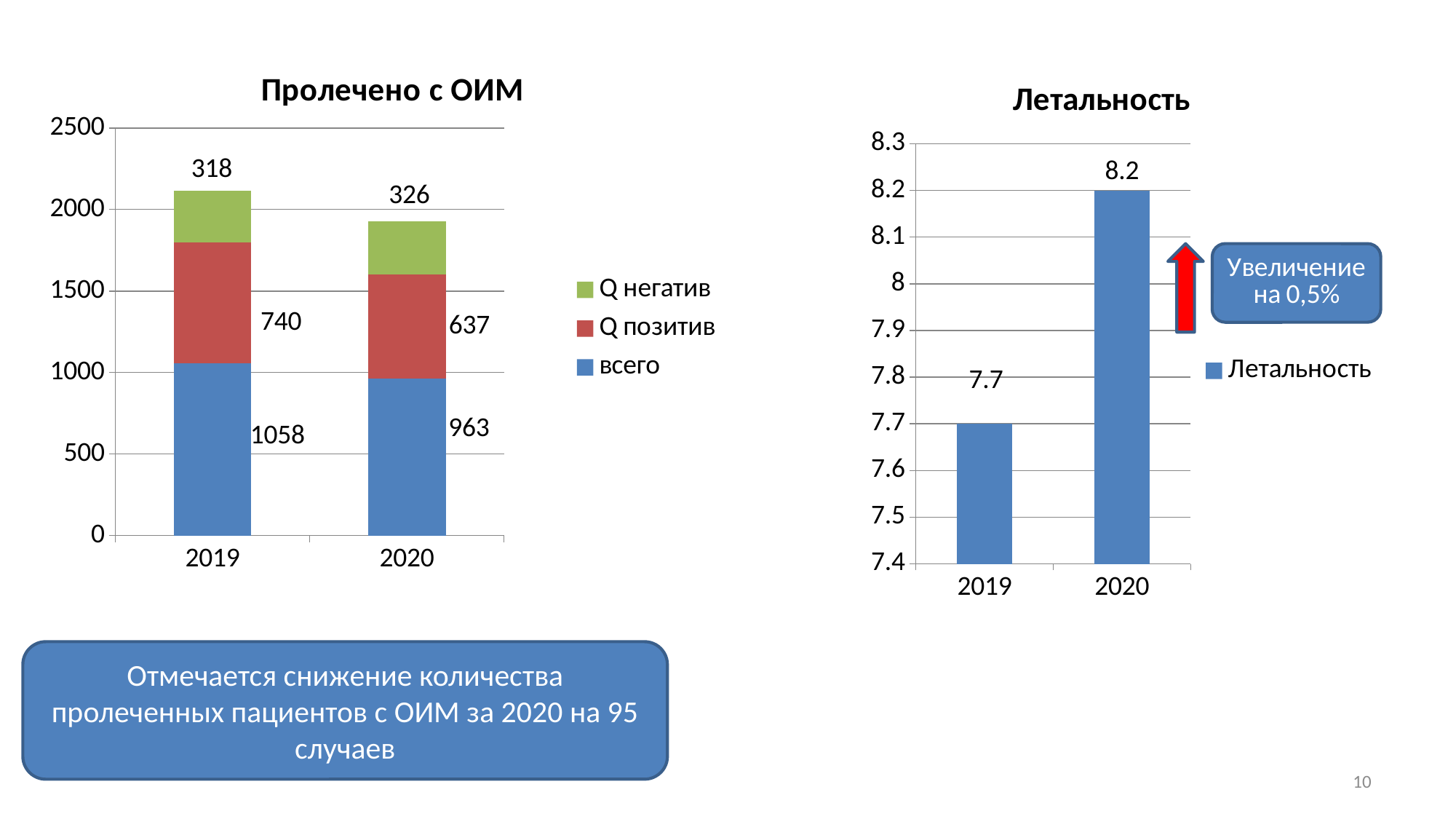
In the chart titled "Пролечено с ОИМ", what is the difference between the "всего" values for 2019 and 2020? 95 In the chart titled "Летальность", which year has the highest value? 2020 In the chart titled "Пролечено с ОИМ", which year has the larger "Q позитив" value, 2019 or 2020? 2019 In the chart titled "Пролечено с ОИМ", what colour represents the "Q негатив" series? Green In the chart titled "Пролечено с ОИМ", what is the value of the "Q негатив" series for 2019? 318 In the chart titled "Летальность", what is the difference between the 2020 and 2019 values? 0.5 In the chart titled "Летальность", what is the value for 2019? 7.7 In the chart titled "Пролечено с ОИМ", what is the value of the "Q позитив" series for 2020? 637 In the chart titled "Пролечено с ОИМ", how many series does the legend list? 3 In the chart titled "Пролечено с ОИМ", what is the value of the "всего" series for 2019? 1058 In the chart titled "Летальность", what is the value for 2020? 8.2 What kind of chart is the chart titled "Летальность"? Bar chart